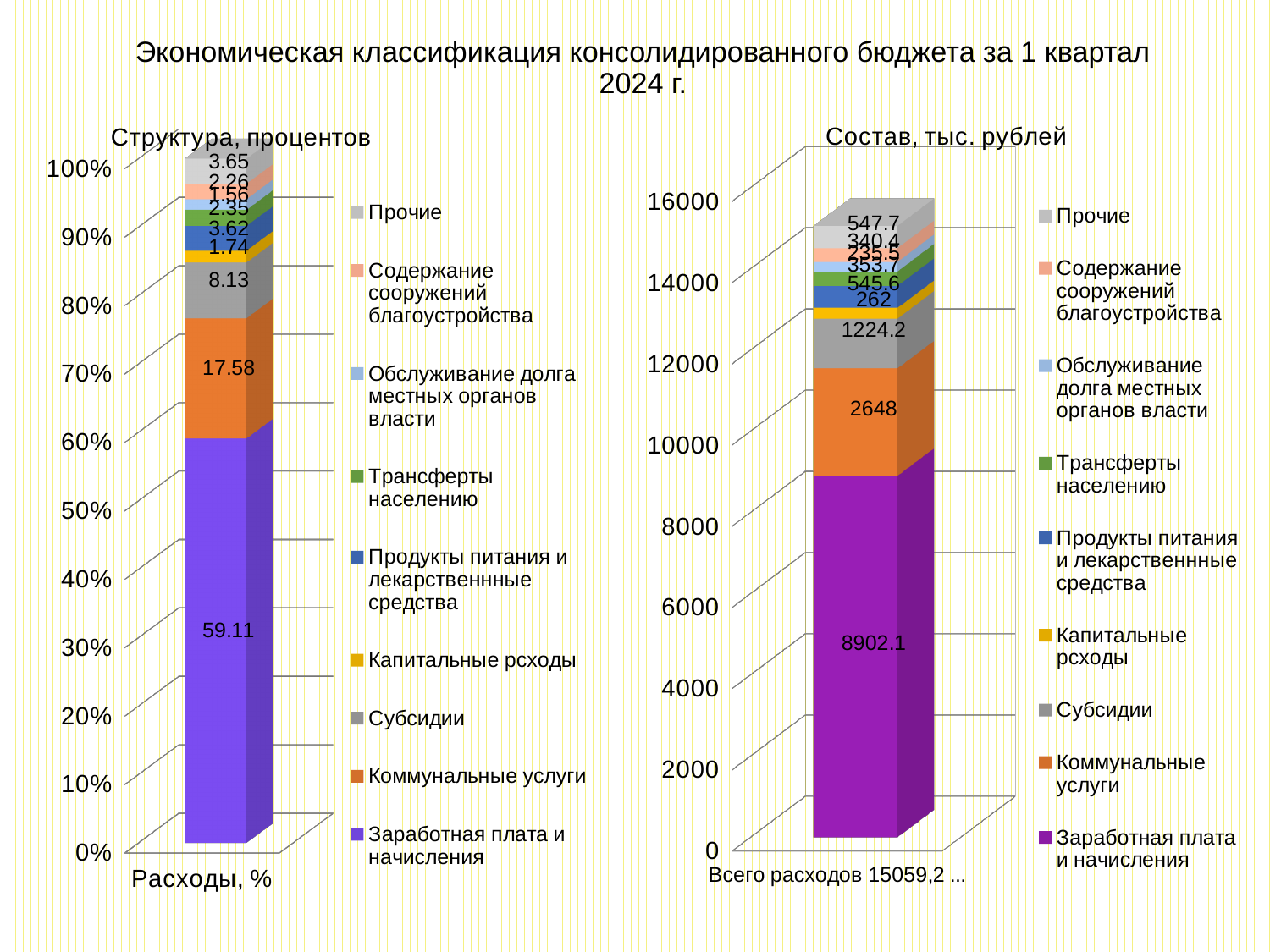
How many series does the legend of the right chart (Состав, тыс. рублей) list? 9 In the right chart (Состав, тыс. рублей), what is the total of the stacked bar? 15059,2 In the right chart (Состав, тыс. рублей), is the top of the stacked bar greater or less than 14000? greater In the right chart (Состав, тыс. рублей), which is larger: Субсидии or Продукты питания и лекарственнные средства? Субсидии In the right chart (Состав, тыс. рублей), what is the value for Прочие? 547.7 In the left chart (Структура, процентов), which series has the largest segment? Заработная плата и начисления In the right chart (Состав, тыс. рублей), which series has the smallest value? Обслуживание долга местных органов власти In the right chart (Состав, тыс. рублей), what is the value for Коммунальные услуги? 2648 In the left chart (Структура, процентов), what is the value for Заработная плата и начисления? 59.11 What kind of chart is the left chart (Структура, процентов)? Stacked bar chart In the left chart (Структура, процентов), what is the value for Трансферты населению? 2.35 In the left chart (Структура, процентов), what is the difference between the values for Коммунальные услуги and Субсидии? 9.45